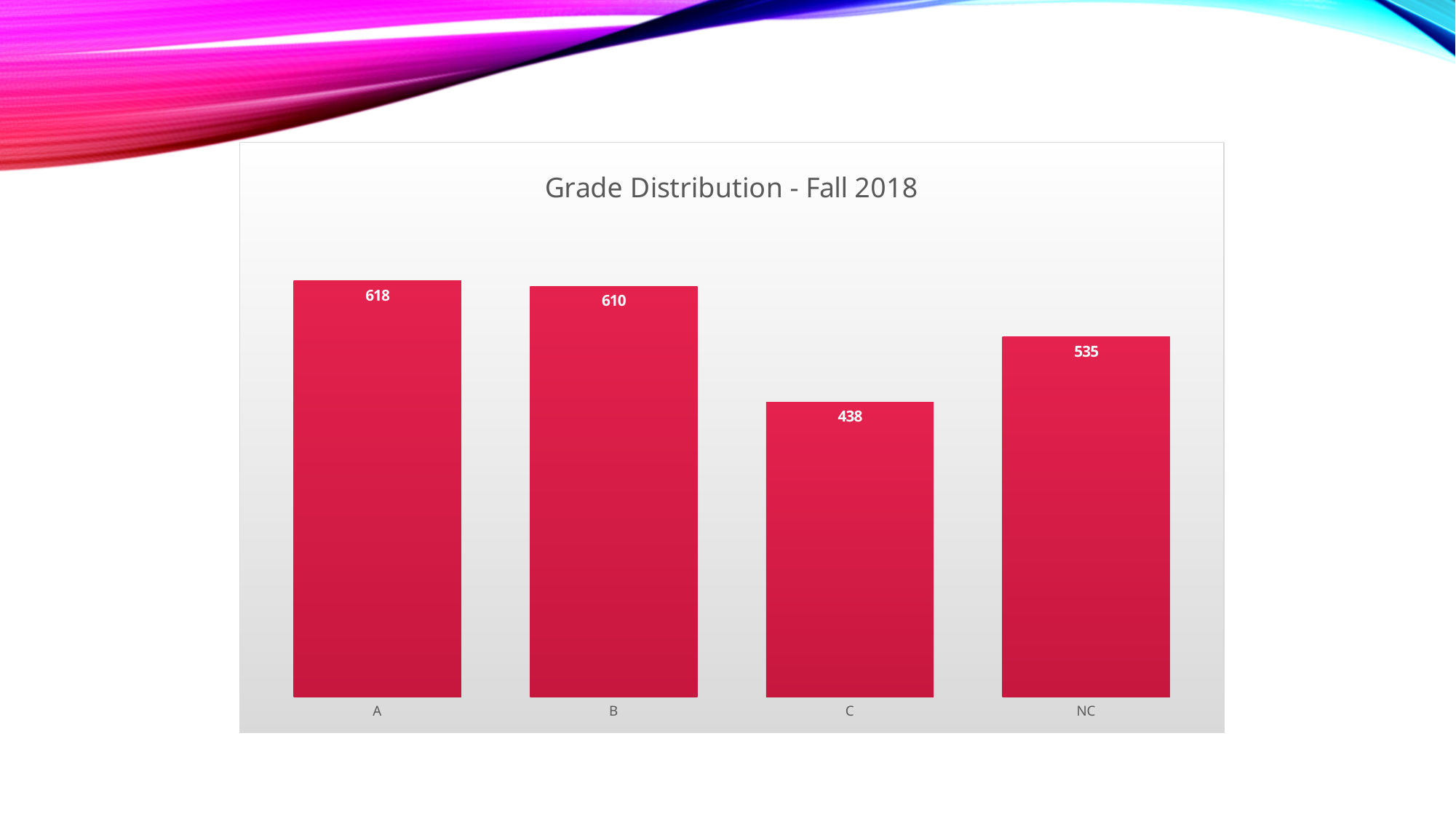
How many categories are shown in the chart? 4 What is the value for grade A? 618 What is the value for grade C? 438 What is the difference between the values for A and C? 180 Which is larger, the value for NC or the value for C? NC What is the title of the chart? Grade Distribution - Fall 2018 What is the value for grade B? 610 What is the value for NC? 535 What kind of chart is shown on the slide? Bar chart What is the difference between the values for NC and C? 97 Which category has the highest value? A Which category has the lowest value? C